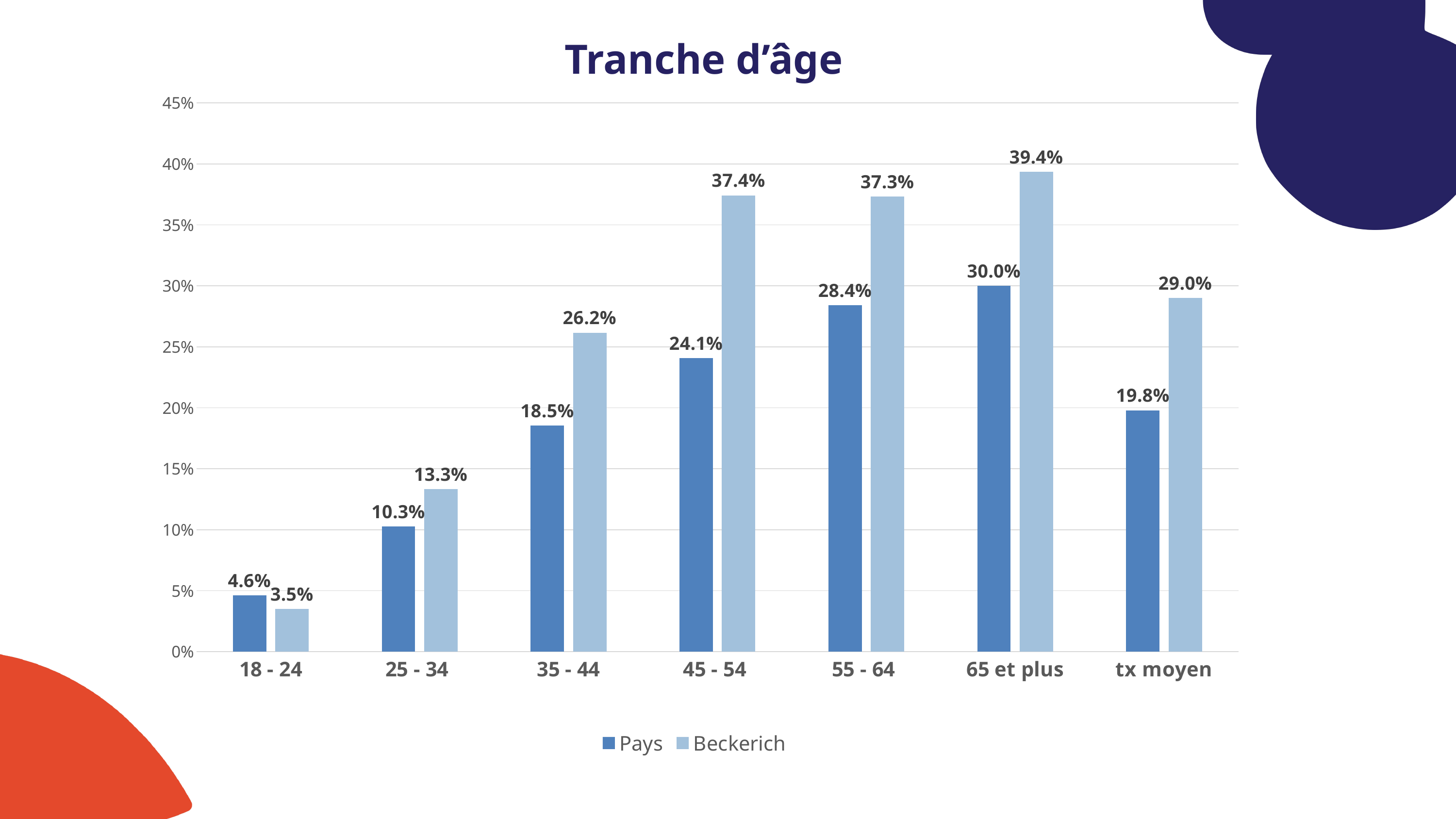
What is the difference between the Beckerich and Pays values in the 65 et plus category? 9.4% How many categories are shown on the x axis? 7 What kind of chart is shown on the slide? Bar chart How many series does the legend list? 2 Which category has the lowest Pays value? 18 - 24 Which category has the highest Beckerich value? 65 et plus What is the value for Beckerich in the 25 - 34 category? 13.3% What is the value for Pays in the 45 - 54 category? 24.1% What is the value for Beckerich in the tx moyen category? 29.0% Which is larger in the 18 - 24 category, Pays or Beckerich? Pays Do the Pays values rise or fall from 18 - 24 to 65 et plus? Rise What is the title of the chart? Tranche d'âge